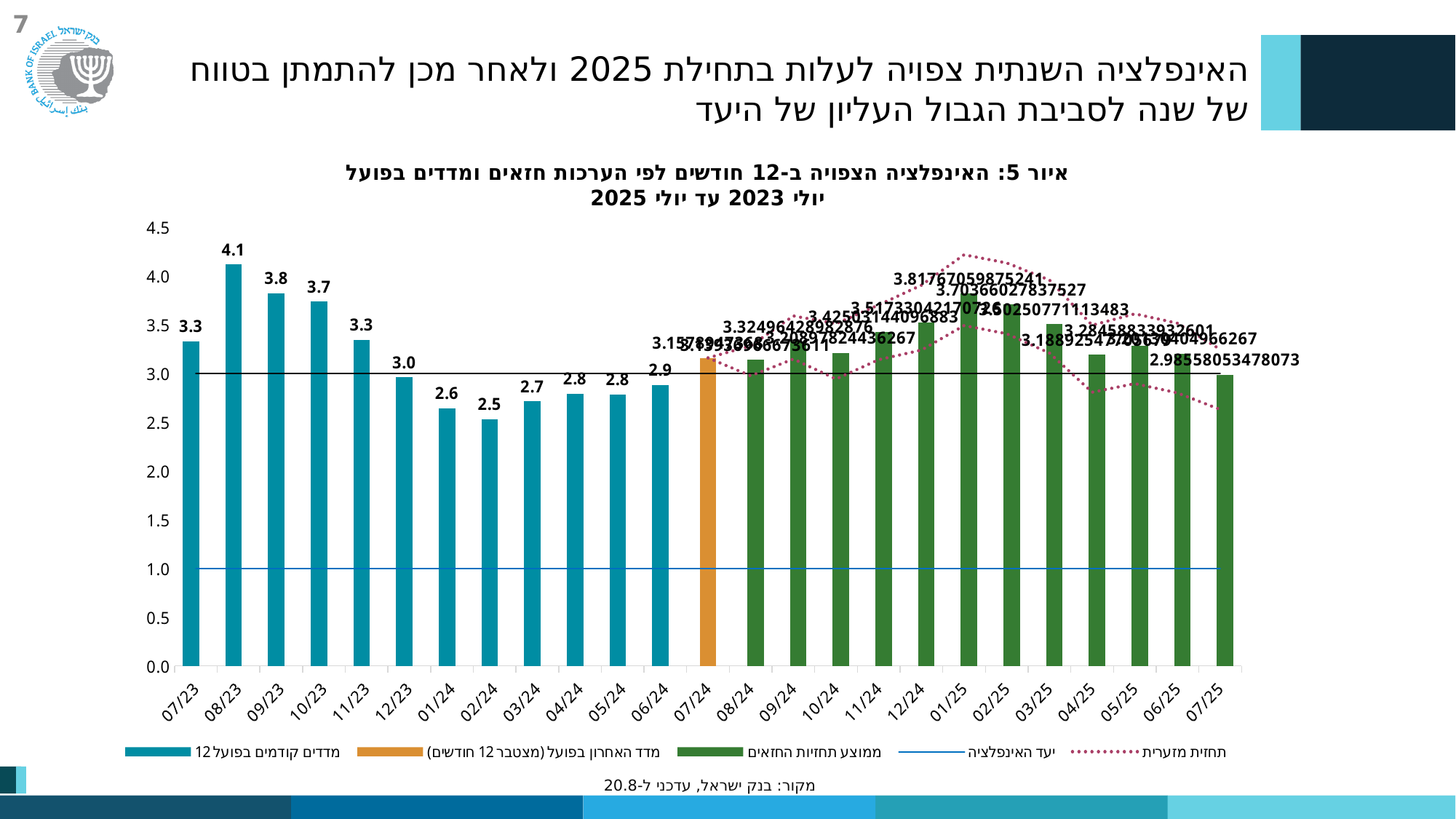
How many entries does the legend list? 5 Which is larger, the value for 09/23 or the value for 10/23? 09/23 How many months are shown on the x axis? 25 Which month has the lowest bar in the chart? 02/24 What is the value for 02/24? 2.5 What is the difference between the values for 08/23 and 02/24? 1.6 What kind of chart is shown on the slide? combination bar and line chart Do the bar values rise or fall from 08/23 to 02/24? fall Is the value for 01/25 greater or less than 3.5? greater What is the value for 08/23? 4.1 What is the value for 12/23? 3.0 Which month has the highest bar in the chart? 08/23